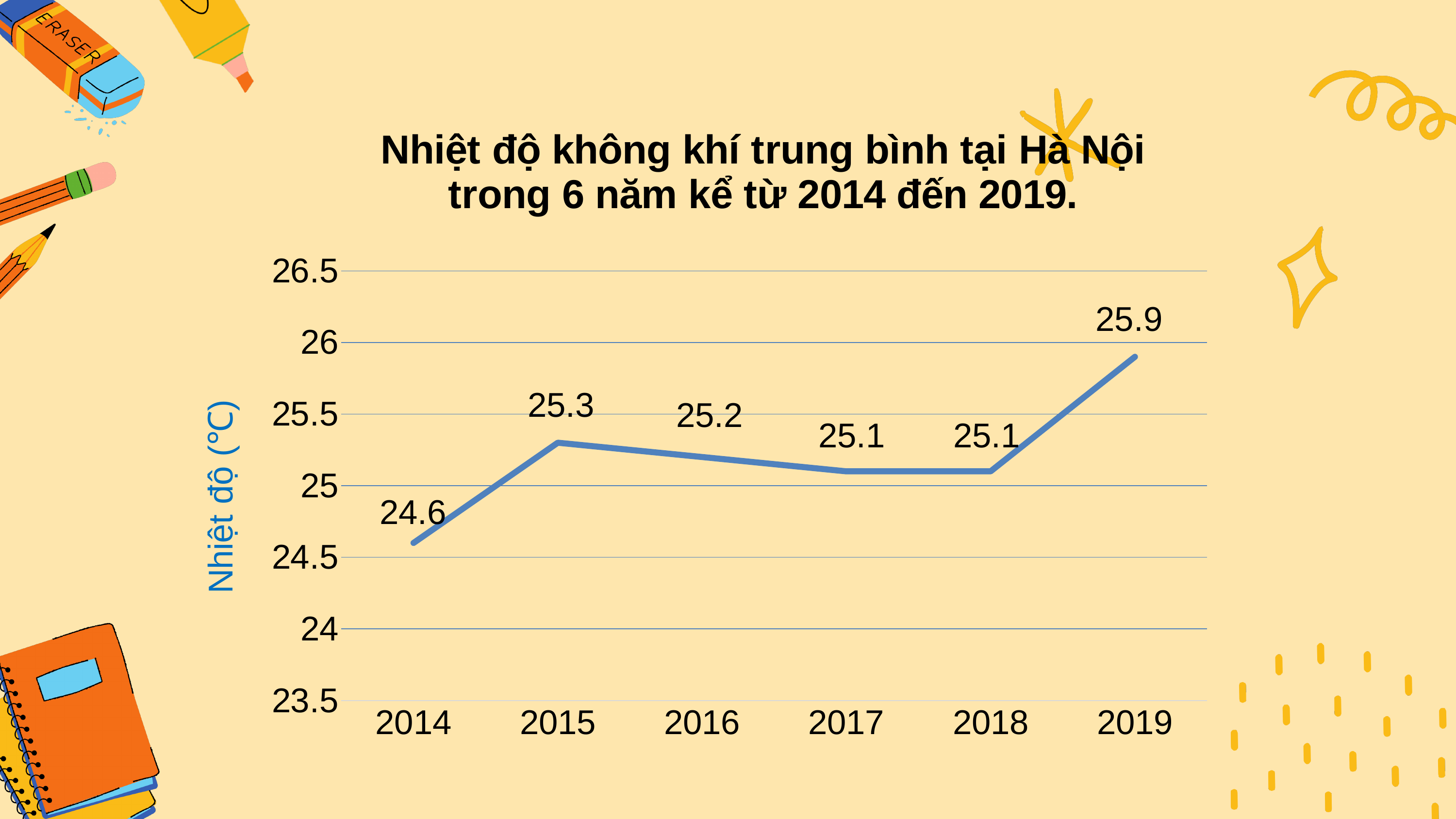
Does the temperature rise or fall from 2018 to 2019? rise What value is shown for 2016? 25.2 What is the difference between the temperature in 2019 and in 2014? 1.3 Which year has the highest average temperature? 2019 What was the average air temperature in Hanoi in 2014? 24.6 What was the average air temperature in Hanoi in 2019? 25.9 What is the label on the vertical axis? Nhiệt độ (°C) Which year had a higher average temperature, 2015 or 2016? 2015 What kind of chart is shown on the slide? line chart How many years are plotted on the chart? 6 Is the value for 2019 greater or less than 26? less Which year has the lowest average temperature? 2014